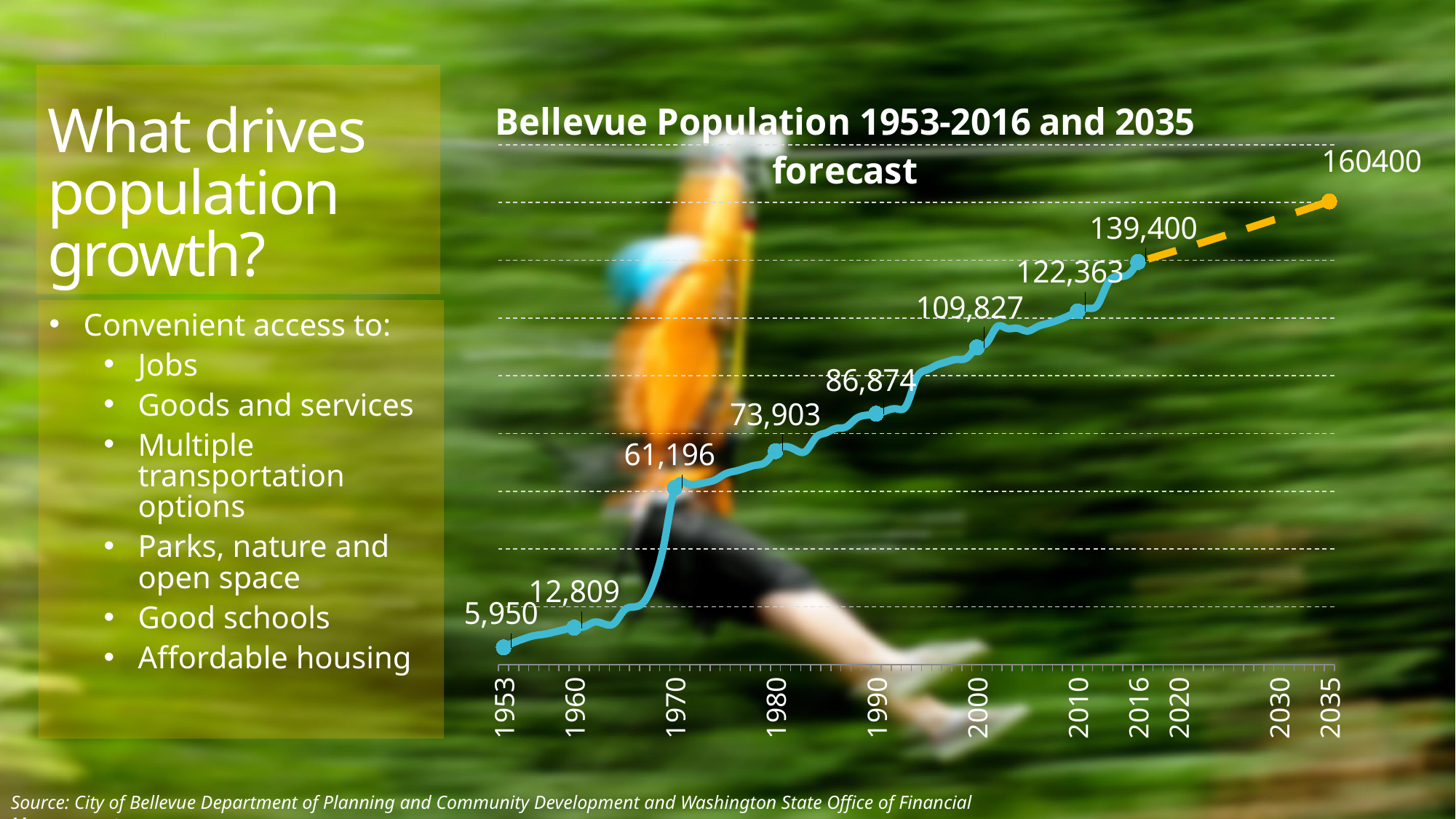
What is the title of the chart? Bellevue Population 1953-2016 and 2035 forecast What was Bellevue's population in 1953? 5,950 What was Bellevue's population in 2000? 109,827 What is the difference between the 2016 population and the 2010 population? 17,037 Does the population rise or fall over the years shown on the chart? rise What was Bellevue's population in 1970? 61,196 Which year has the lowest population value on the chart? 1953 By how much did the population grow between 1960 and 1970? 48,387 How many data points have value labels on the chart? 9 What is the forecast population for 2035? 160400 What kind of chart is shown on the slide? line chart Which year has the highest population value on the chart? 2035